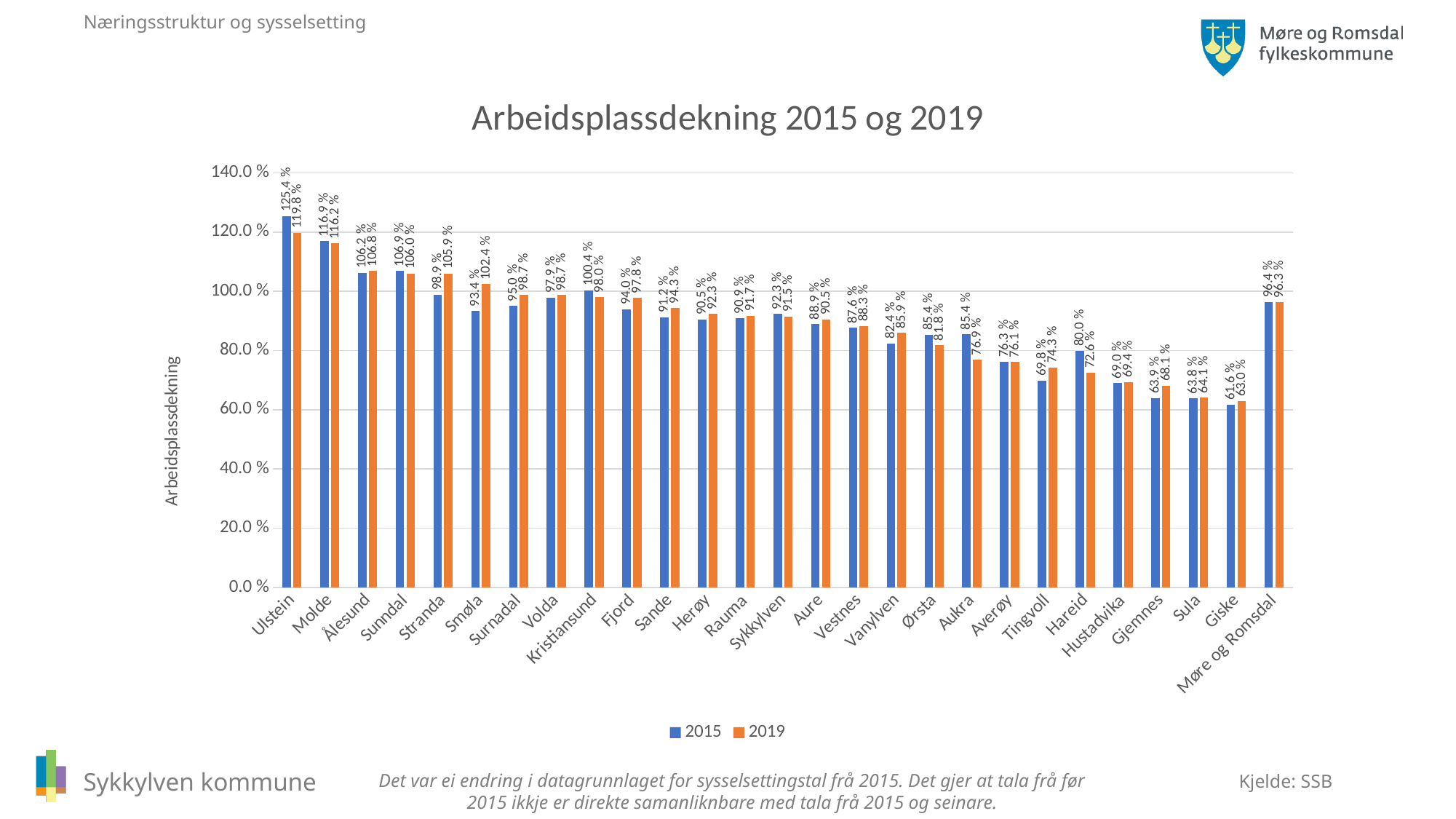
Which category has the highest value in the 2015 series? Ulstein For Hareid, which year has the larger value, 2015 or 2019? 2015 What is the difference between the 2015 and 2019 values for Smøla? 9.0 percentage points What is the title of the chart? Arbeidsplassdekning 2015 og 2019 For Tingvoll, which year has the larger value, 2015 or 2019? 2019 Which category has the lowest value in the 2019 series? Giske What is the value for Sykkylven in 2015? 92.3 % What is the 2019 value for Møre og Romsdal? 96.3 % What is the value for Stranda in 2019? 105.9 % What is the difference between the 2015 and 2019 values for Aukra? 8.5 percentage points How many categories are shown on the x axis? 27 How many series does the legend list? 2